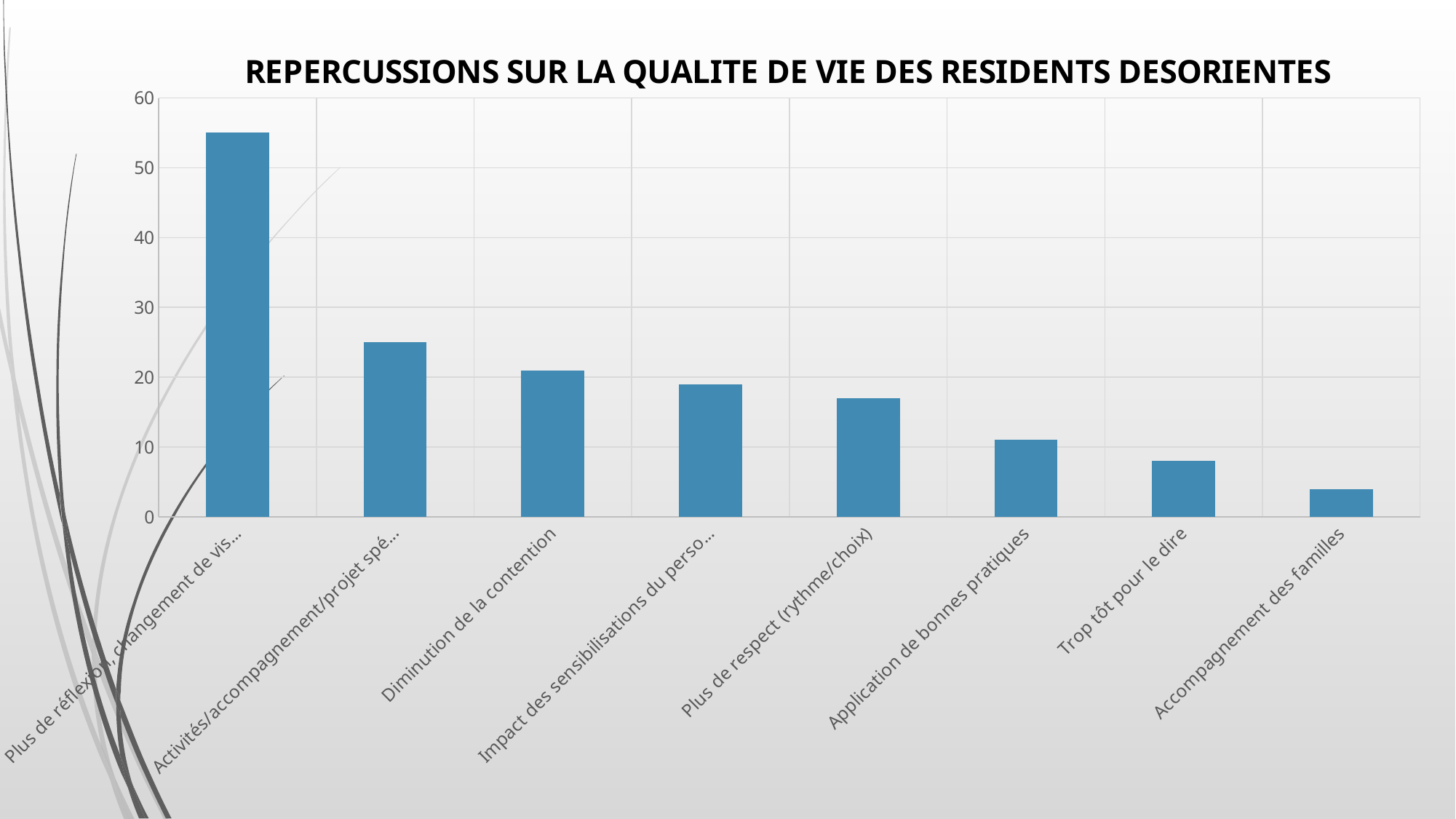
How many bars (categories) does the chart show? 8 Is the value for 'Accompagnement des familles' greater or less than 10? less Which is larger: the value for 'Trop tôt pour le dire' or for 'Accompagnement des familles'? Trop tôt pour le dire What type of chart is shown on the slide? Bar chart Which is larger: the value for 'Diminution de la contention' or for 'Plus de respect (rythme/choix)'? Diminution de la contention Is the value for 'Plus de respect (rythme/choix)' greater or less than 20? less Is the value for 'Diminution de la contention' greater or less than 30? less What is the title of the chart? REPERCUSSIONS SUR LA QUALITE DE VIE DES RESIDENTS DESORIENTES Do the bar values rise or fall from left to right across the chart? Fall Which category has the lowest value in the chart? Accompagnement des familles